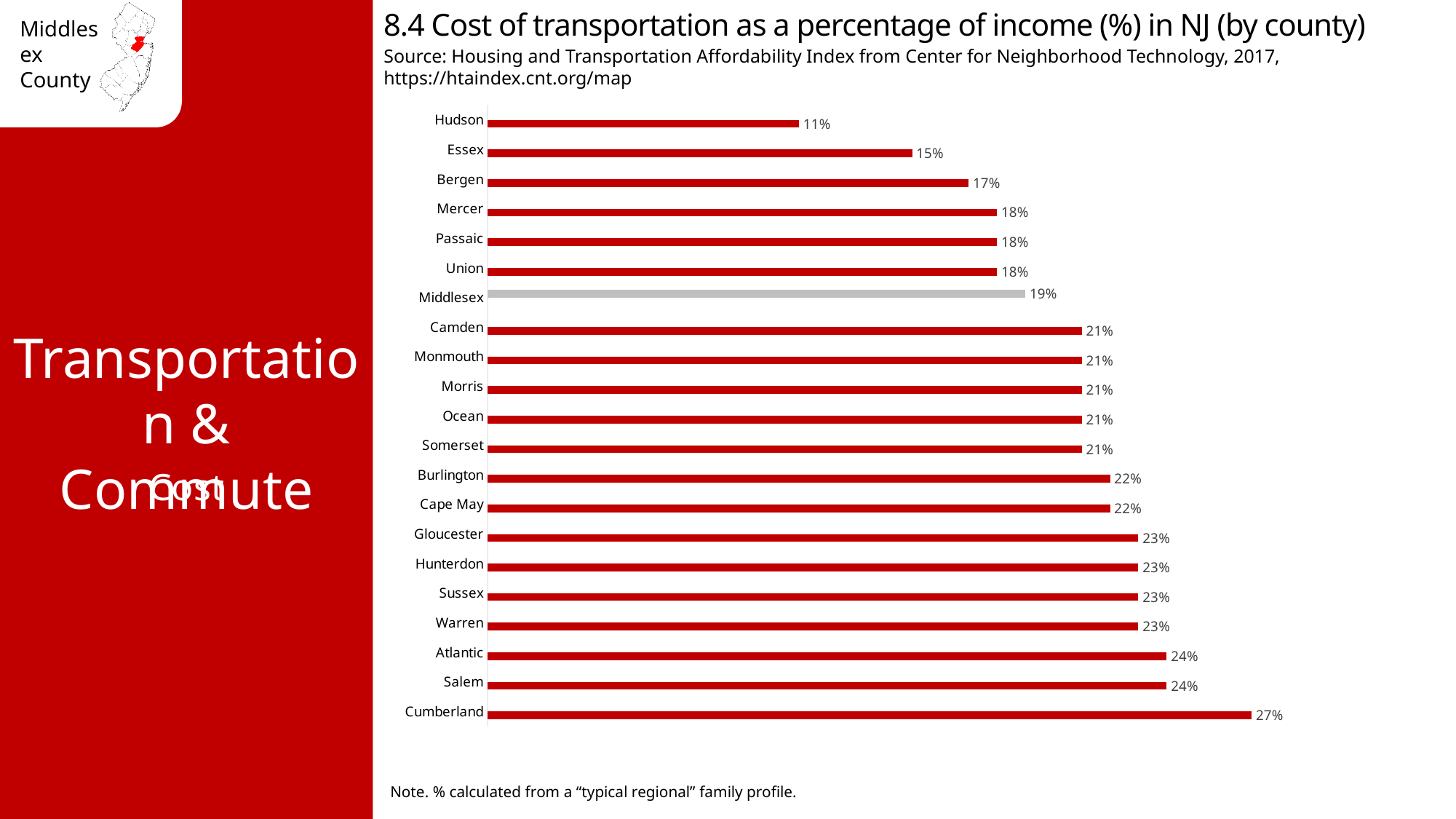
What is the difference between the values for Middlesex and Essex? 4% Which county's bar is shown in gray rather than red? Middlesex Which county has the highest cost of transportation as a percentage of income? Cumberland Which has a higher value, Mercer or Essex? Mercer Which county has the lowest cost of transportation as a percentage of income? Hudson Which has a higher value, Atlantic or Camden? Atlantic What is the cost of transportation as a percentage of income for Hudson County? 11% How many counties are shown in the chart? 21 What is the difference between the values for Cumberland and Hudson? 16% What is the cost of transportation as a percentage of income for Middlesex County? 19% What kind of chart is shown on the slide? Bar chart What is the value shown for Bergen County? 17%